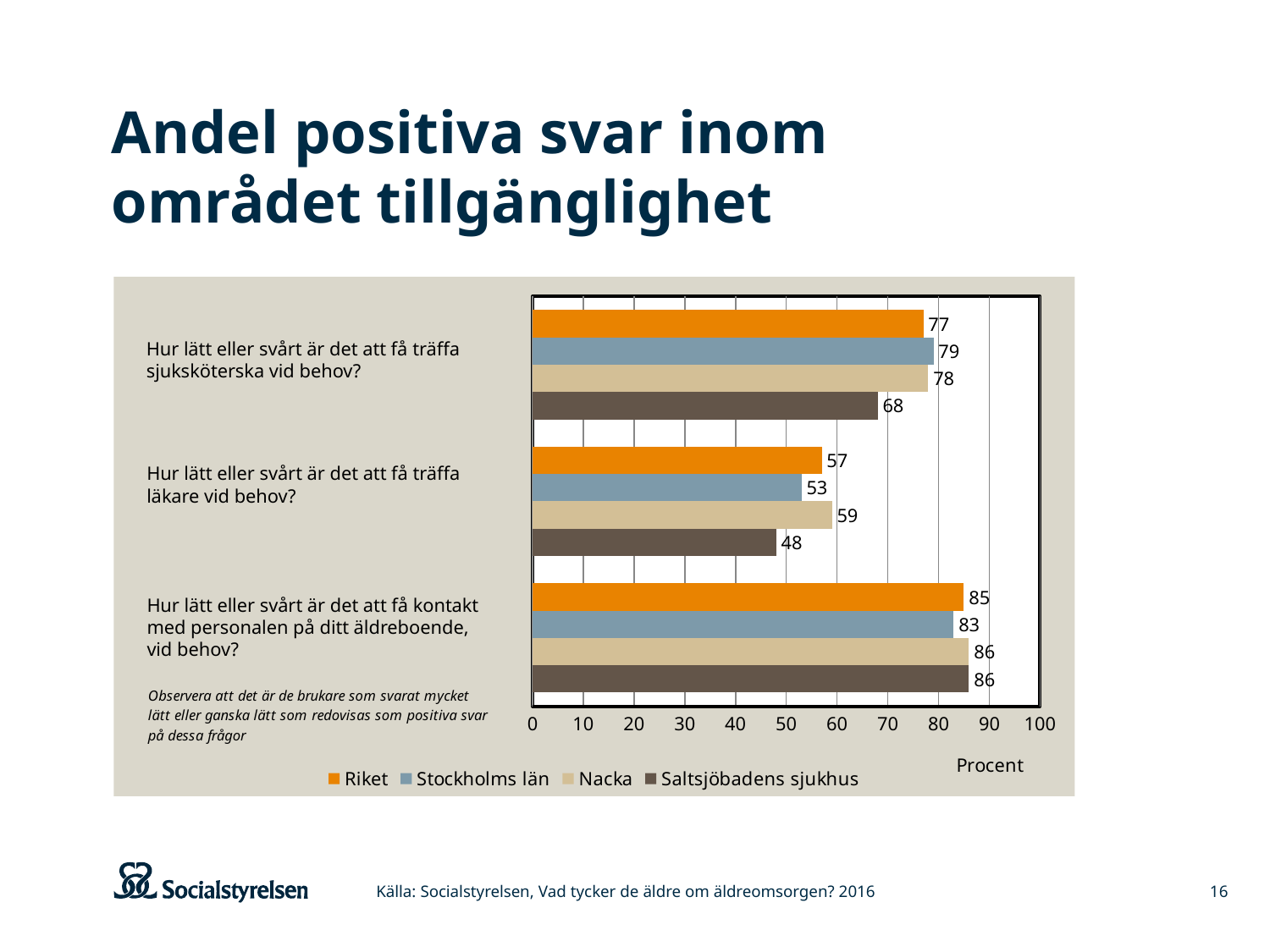
Which series has the lowest value on the question about meeting a doctor when needed (träffa läkare vid behov)? Saltsjöbadens sjukhus What is the value for Saltsjöbadens sjukhus on the question about meeting a nurse when needed (träffa sjuksköterska vid behov)? 68 How many question categories are shown on the chart? 3 What kind of chart is shown on the slide? Bar chart Which is larger on the question about meeting a nurse when needed: Riket or Saltsjöbadens sjukhus? Riket Which series has the highest value on the question about meeting a nurse when needed (träffa sjuksköterska vid behov)? Stockholms län Which series is shown in orange in the legend? Riket What is the difference between Riket and Saltsjöbadens sjukhus on the question about meeting a doctor when needed (träffa läkare vid behov)? 9 What is the value for Nacka on the question about meeting a doctor when needed (träffa läkare vid behov)? 59 How many series does the legend list? 4 What is the unit label shown below the horizontal axis? Procent What is the value for Riket on the question about getting in contact with staff at the care home (kontakt med personalen)? 85